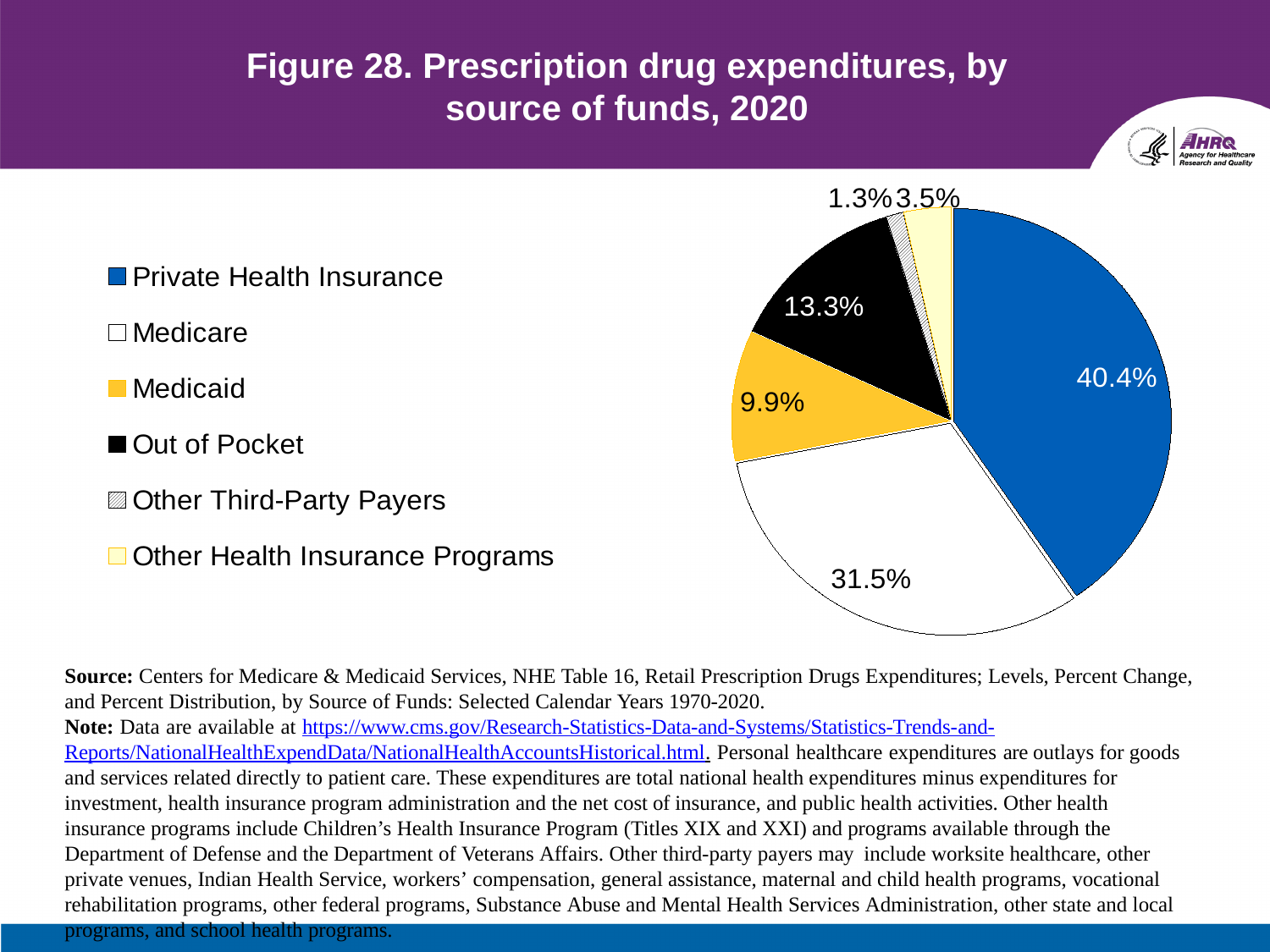
What percentage is shown for Other Health Insurance Programs? 3.5% What is the difference in percentage points between the Private Health Insurance and Medicare shares? 8.9 Which is larger, the Out of Pocket share or the Medicaid share? Out of Pocket Which source of funds has the largest share of prescription drug expenditures? Private Health Insurance What share of prescription drug expenditures came from Private Health Insurance in 2020? 40.4% Which source of funds has the smallest share of prescription drug expenditures? Other Third-Party Payers What share of prescription drug expenditures came from Medicare? 31.5% What type of chart is shown on the slide? Pie chart What percentage is shown for Out of Pocket? 13.3% How many sources of funds does the legend list? 6 What percentage is shown for Other Third-Party Payers? 1.3% What percentage is shown for Medicaid? 9.9%